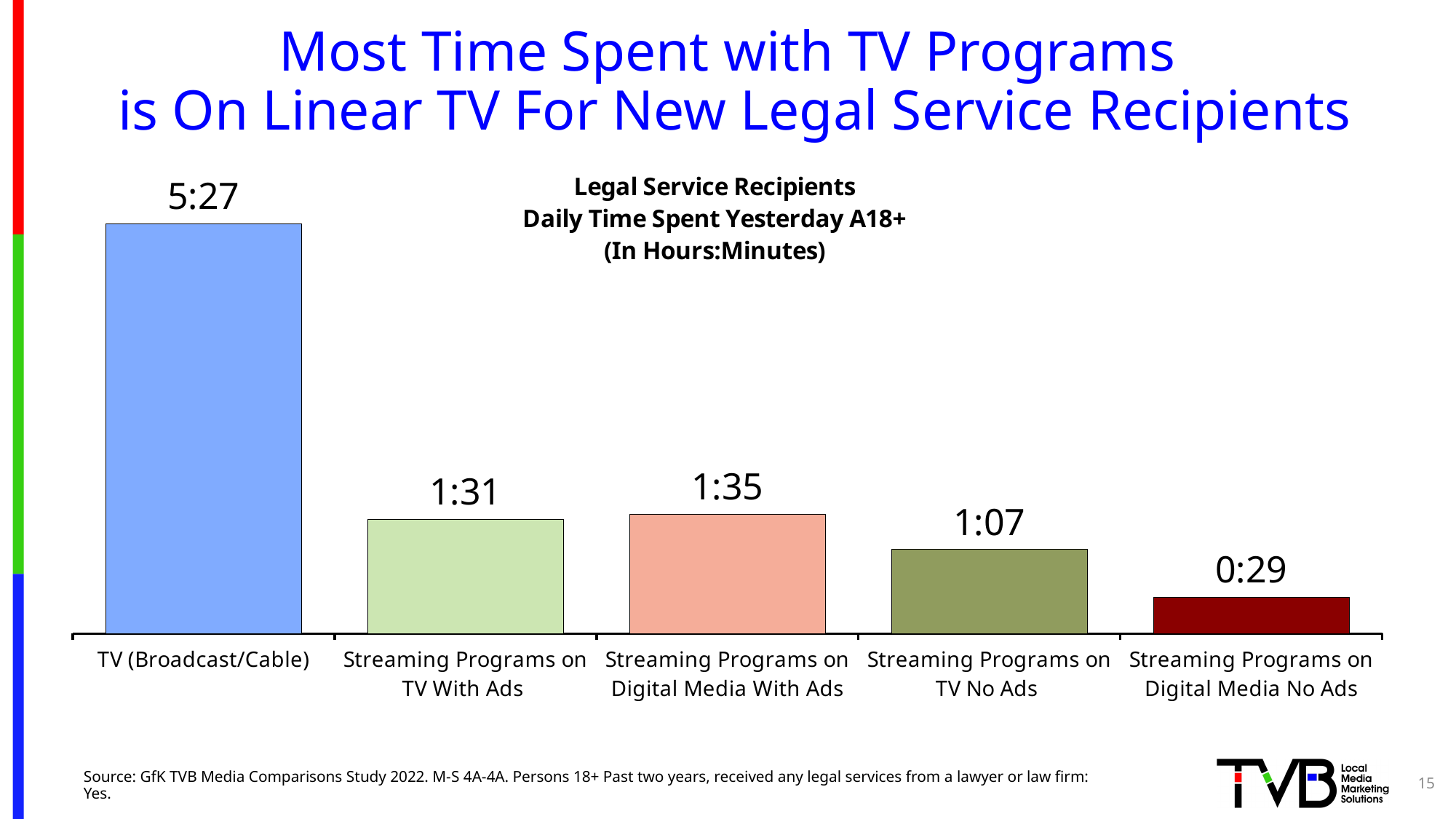
What is the difference in time spent between Streaming Programs on TV With Ads and Streaming Programs on Digital Media No Ads? 1:02 How many categories are shown in the chart? 5 What type of chart is shown on the slide? Bar chart In what units are the values in the chart expressed, according to the chart title? Hours:Minutes How much more time is spent on TV (Broadcast/Cable) than on Streaming Programs on Digital Media With Ads? 3:52 Which category has the highest daily time spent? TV (Broadcast/Cable) What is the daily time spent for Streaming Programs on Digital Media With Ads? 1:35 What is the daily time spent for Streaming Programs on TV No Ads? 1:07 What is the daily time spent for TV (Broadcast/Cable)? 5:27 Which is larger: the time spent on Streaming Programs on TV With Ads or on Streaming Programs on TV No Ads? Streaming Programs on TV With Ads What is the daily time spent for Streaming Programs on Digital Media No Ads? 0:29 Which category has the lowest daily time spent? Streaming Programs on Digital Media No Ads